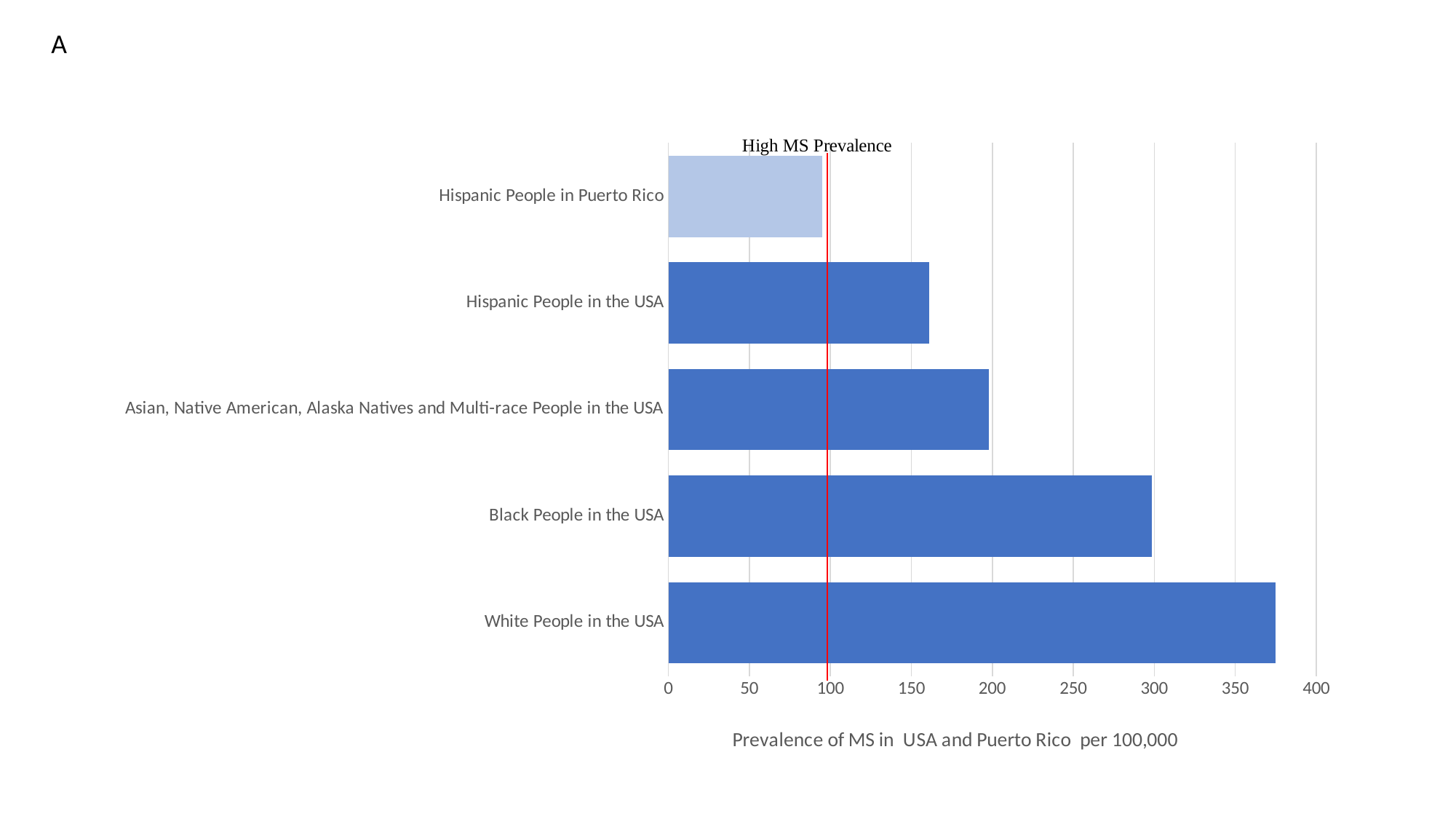
Is the value for Black People in the USA greater or less than 250? greater Which category has the lowest MS prevalence? Hispanic People in Puerto Rico Is the value for White People in the USA greater or less than 350? greater Is the value for Hispanic People in the USA greater or less than 150? greater What kind of chart is shown on the slide? Bar chart Which is larger: the value for Black People in the USA or the value for Hispanic People in the USA? Black People in the USA What label is given to the red vertical line at 100? High MS Prevalence How many categories (bars) does the chart show? 5 Which category has the highest MS prevalence? White People in the USA What is the title of the horizontal axis? Prevalence of MS in USA and Puerto Rico per 100,000